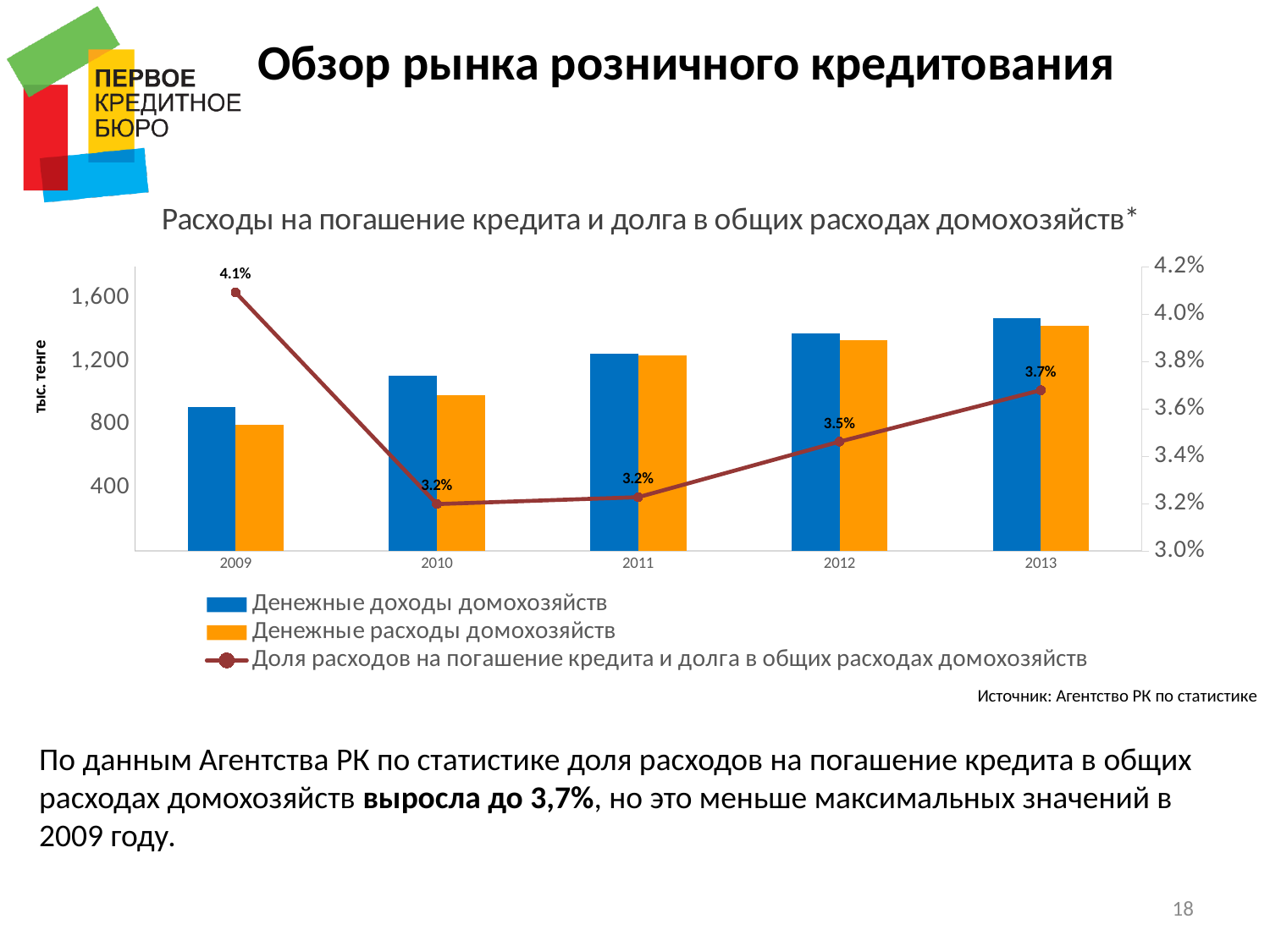
What is the share of expenses on loan and debt repayment in total household expenses in 2009? 4.1% Is the value for household money income in 2009 greater or less than 1,200? less In which year is the share of expenses on loan and debt repayment the highest? 2009 How many years are shown on the x axis of the chart? 5 How does the share of loan and debt repayment expenses change from 2010 to 2013? It rises What is the share of expenses on loan and debt repayment in total household expenses in 2013? 3.7% In 2010, which is larger: household money income or household money expenses? Household money income (Денежные доходы домохозяйств) Is the value for household money income in 2013 greater or less than 1,200? greater What is the share of expenses on loan and debt repayment in 2012? 3.5% How many series does the chart legend list? 3 Which year has the larger share of loan and debt repayment expenses, 2011 or 2012? 2012 By how many percentage points does the share of loan and debt repayment expenses in 2009 exceed that in 2013? 0.4%